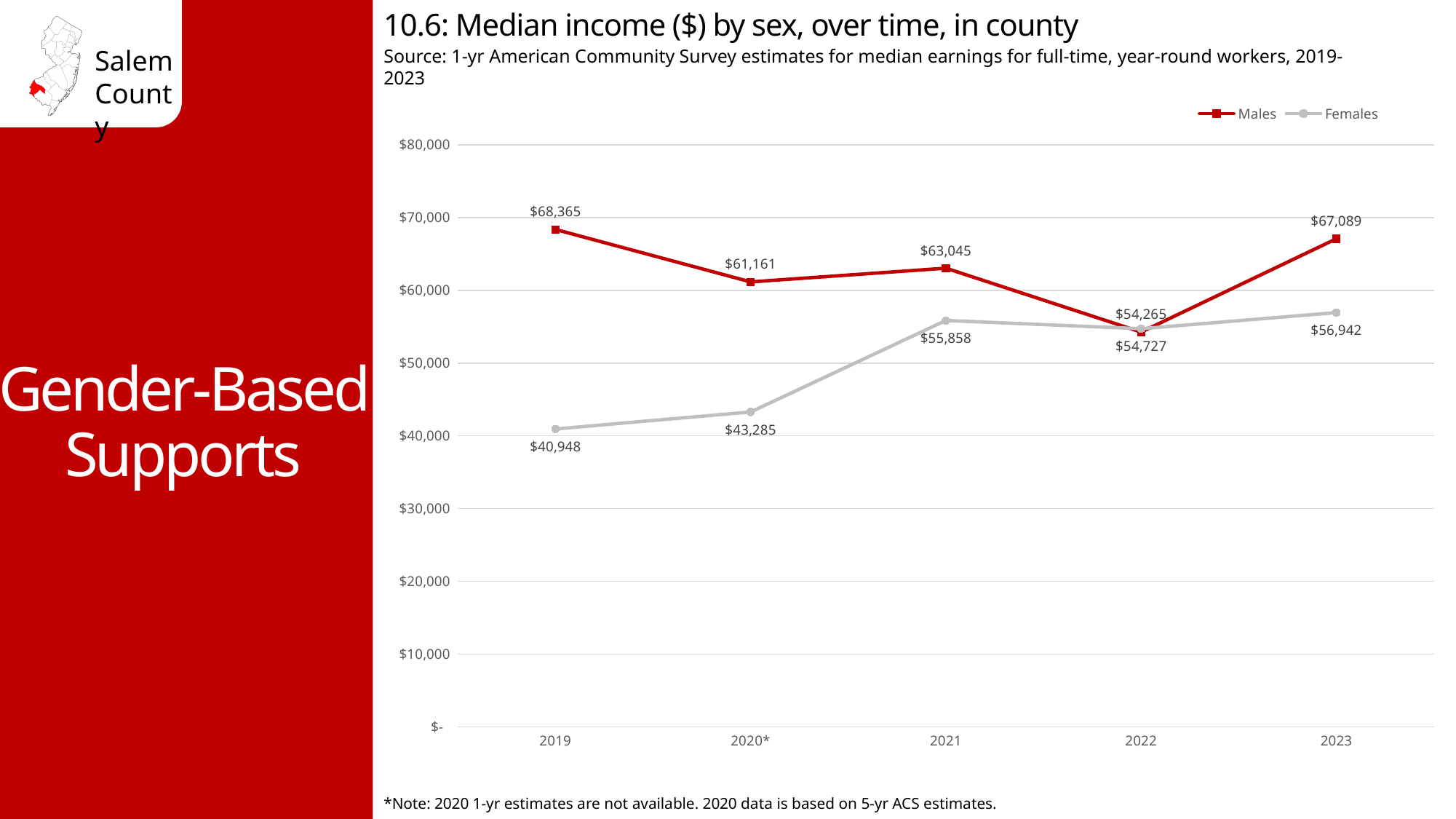
What is the median income for Males in 2019? $68,365 What is the median income for Females in 2020*? $43,285 How many years are shown on the x axis? 5 Does the Females median income generally rise or fall from 2019 to 2023? Rise What kind of chart is shown on the slide? Line chart Which series has the higher median income in 2021, Males or Females? Males What is the median income for Males in 2023? $67,089 In which year is the Males median income highest? 2019 What is the difference between the Males and Females median income in 2019? $27,417 What is the median income for Females in 2021? $55,858 In which year is the Females median income lowest? 2019 How many series does the legend list? 2